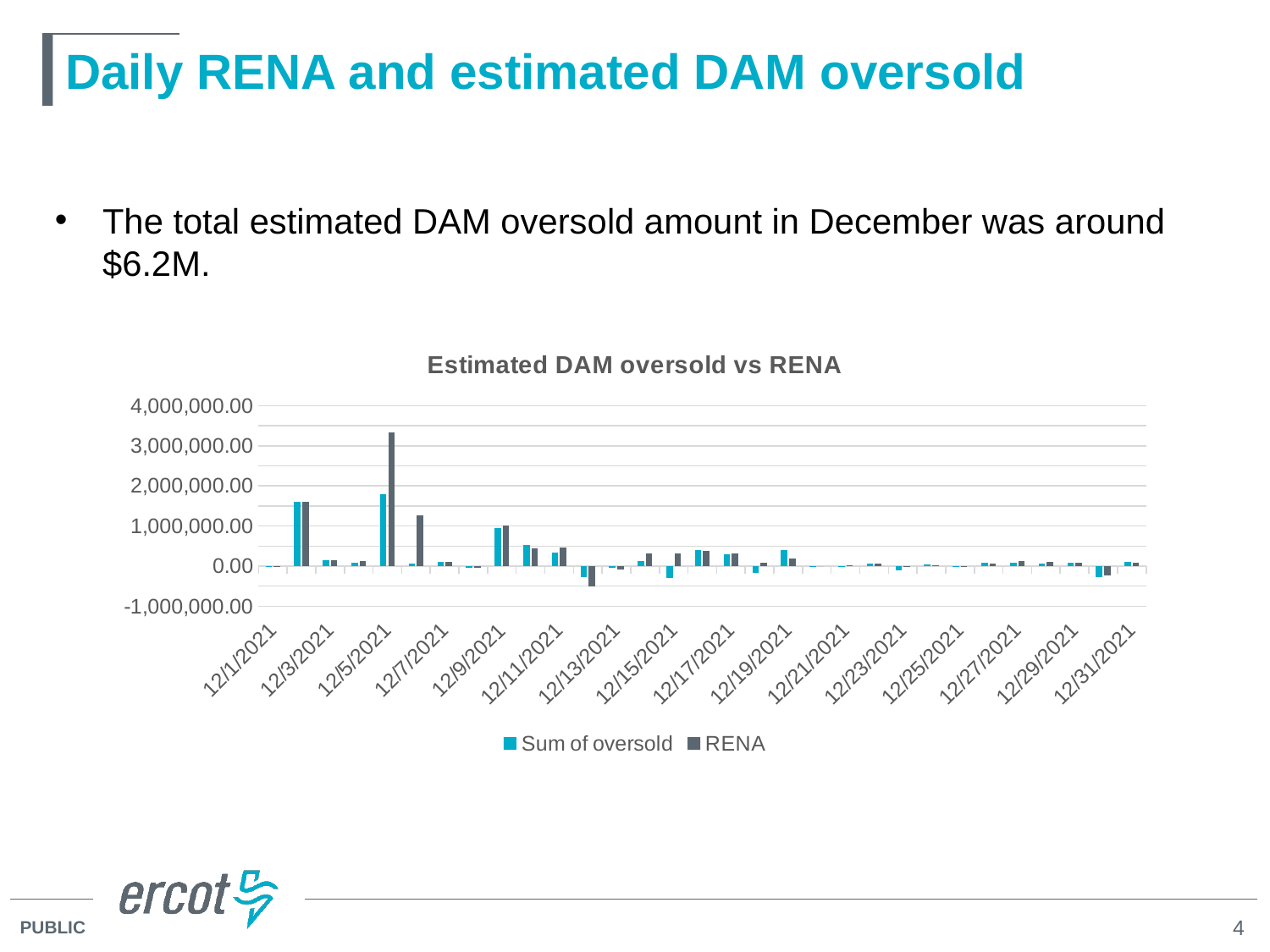
Is the Sum of oversold value on 12/5/2021 greater or less than 1,000,000.00? greater What is the lowest value shown on the chart's y axis? -1,000,000.00 What are the two series named in the chart legend? Sum of oversold and RENA How many date labels are shown on the x axis of the chart? 16 On which date does the RENA series reach its highest value? 12/5/2021 What kind of chart is shown on the slide? Bar chart What is the title of the chart? Estimated DAM oversold vs RENA What is the highest value shown on the chart's y axis? 4,000,000.00 How many series does the chart legend list? 2 On 12/5/2021, which is larger: Sum of oversold or RENA? RENA Is the RENA value on 12/5/2021 greater or less than 3,000,000.00? greater